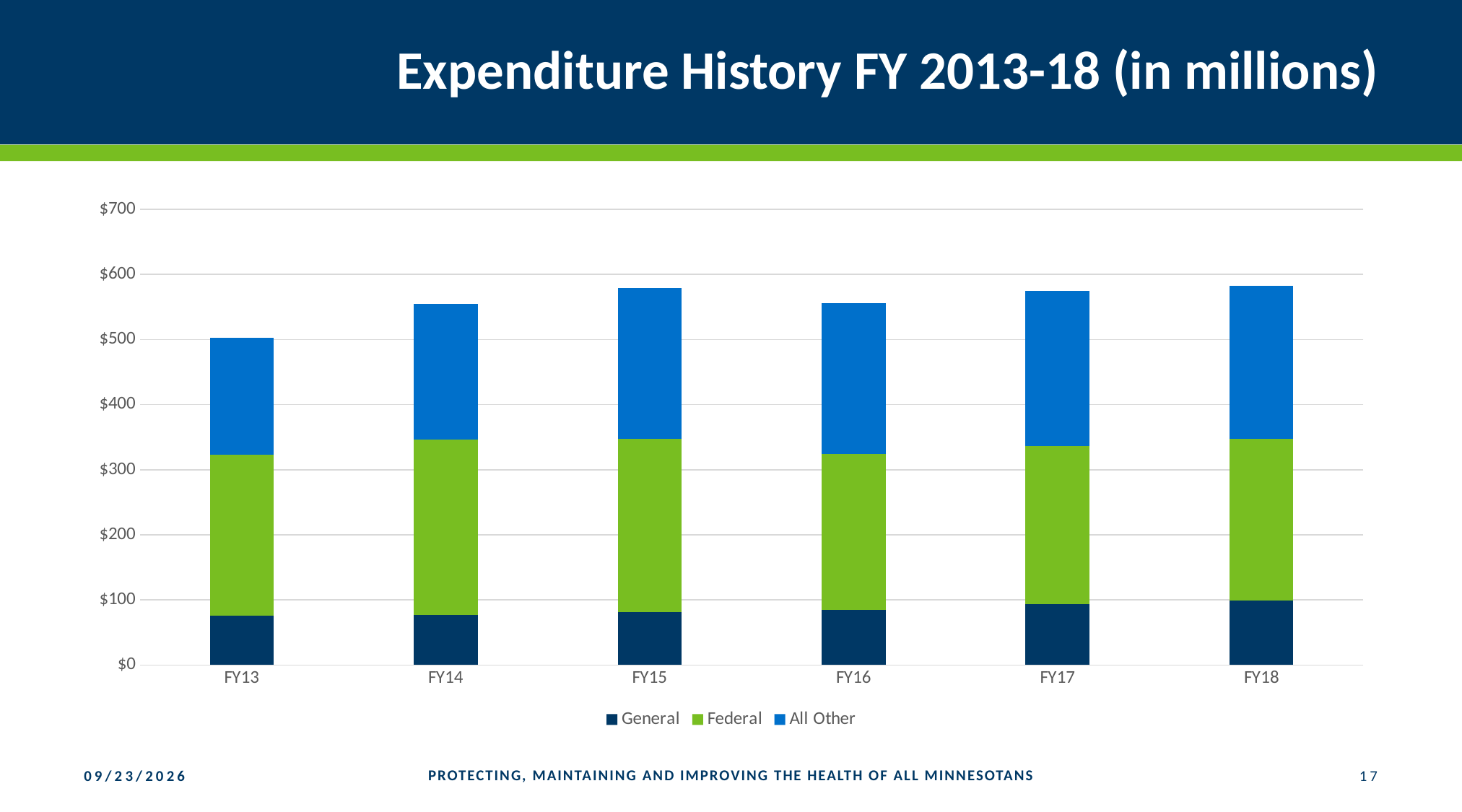
Which fiscal year has the lowest total expenditure? FY13 What kind of chart is shown on the slide? Stacked bar chart How many series does the chart's legend list? 3 Which has the larger total expenditure, FY13 or FY14? FY14 Is the total expenditure for FY15 greater or less than $500? greater Is the total expenditure for FY14 greater or less than $600? less Which has the larger total expenditure, FY15 or FY16? FY15 Does the total expenditure rise or fall from FY13 to FY14? rise Is the total expenditure for FY13 greater or less than $600? less What are the three series listed in the chart's legend? General, Federal, All Other How many fiscal years are shown on the x axis of the chart? 6